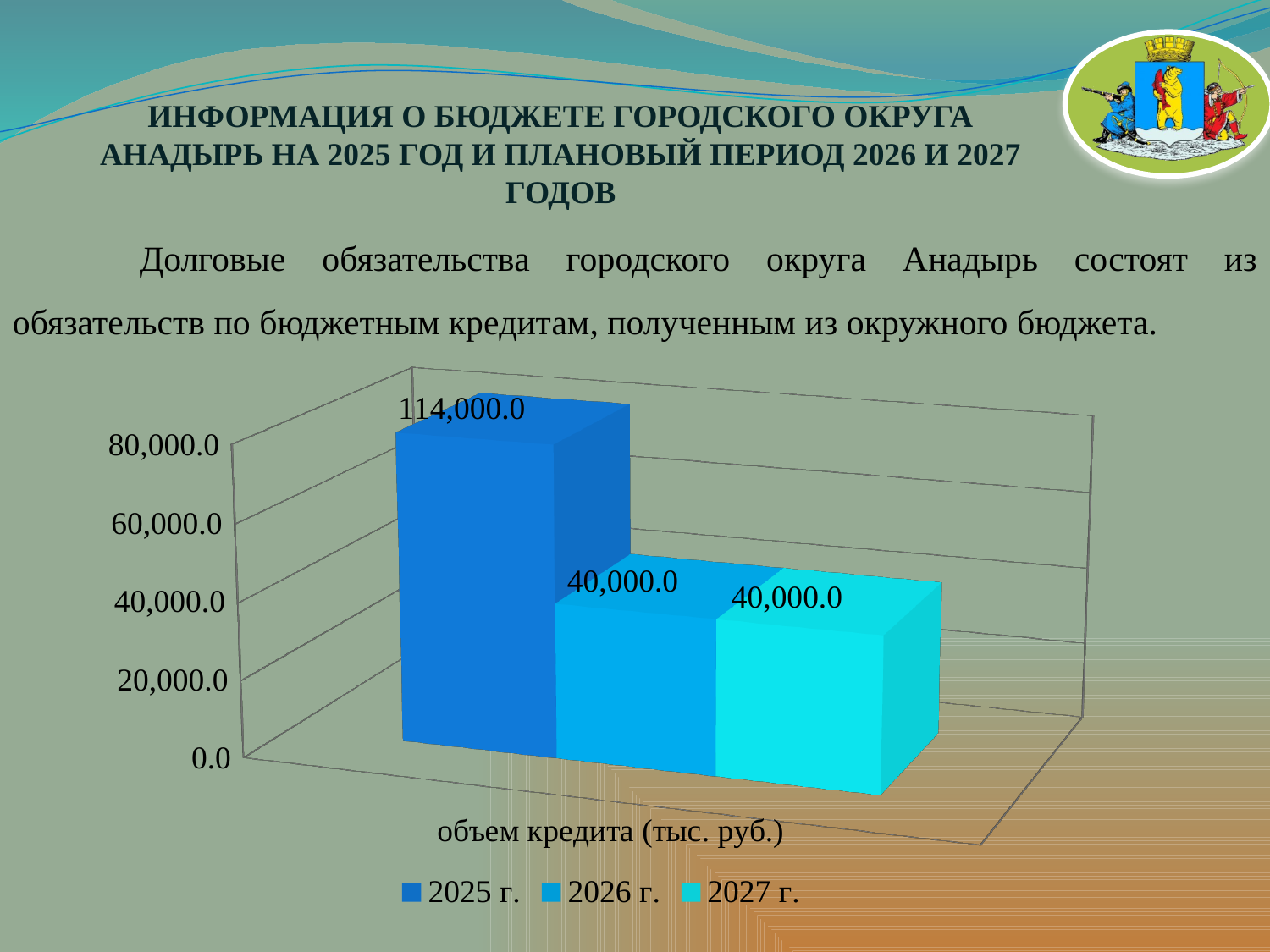
Which year has the highest value in the chart? 2025 г. Is the value for 2025 г. greater or less than 80,000.0? greater What is the label on the horizontal axis of the chart? объем кредита (тыс. руб.) What is the value for 2026 г. in the chart? 40,000.0 What is the difference between the values for 2025 г. and 2026 г.? 74,000.0 Is the value for 2026 г. greater or less than 60,000.0? less How many series does the legend list? 3 What is the value for 2025 г. in the chart? 114,000.0 What kind of chart is shown on the slide? bar chart What is the value for 2027 г. in the chart? 40,000.0 Do the values rise or fall from 2025 г. to 2027 г.? fall Which is larger, the value for 2025 г. or the value for 2027 г.? 2025 г.